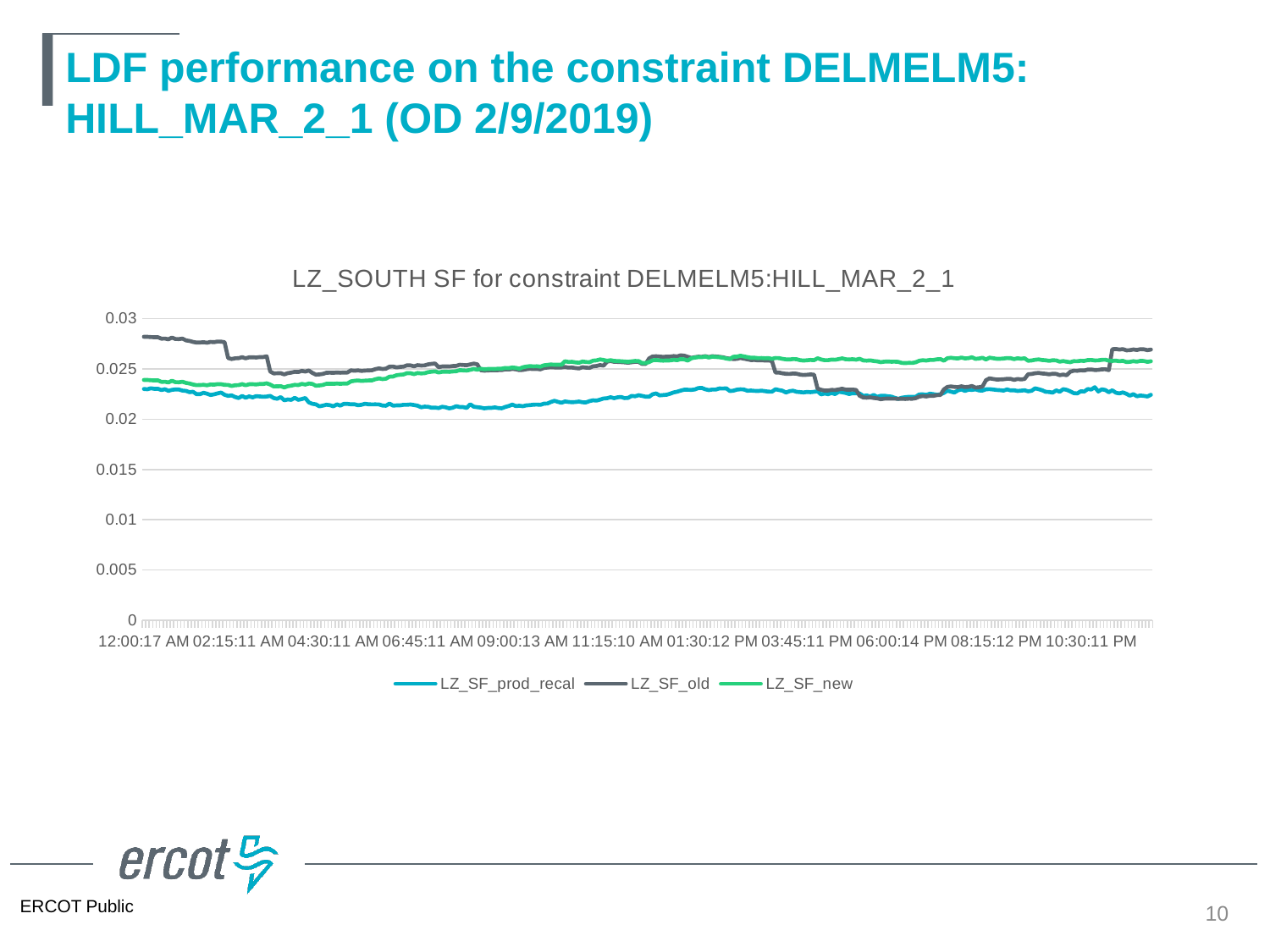
Is the value of LZ_SF_new at 11:15:10 AM greater or less than 0.025? greater Does the LZ_SF_old series rise or fall between 12:00:17 AM and 04:30:11 AM? fall What kind of chart is shown on the slide? line chart How many series does the legend list? 3 At 12:00:17 AM, which series has the higher value, LZ_SF_old or LZ_SF_prod_recal? LZ_SF_old What is the title of the chart? LZ_SOUTH SF for constraint DELMELM5:HILL_MAR_2_1 How many time labels are shown on the x axis? 11 Is the value of LZ_SF_prod_recal at 12:00:17 AM greater or less than 0.025? less Is the value of LZ_SF_prod_recal at 06:45:11 AM greater or less than 0.025? less Which colour is used for the LZ_SF_new series? green Which series has the lowest value at 04:30:11 AM? LZ_SF_prod_recal